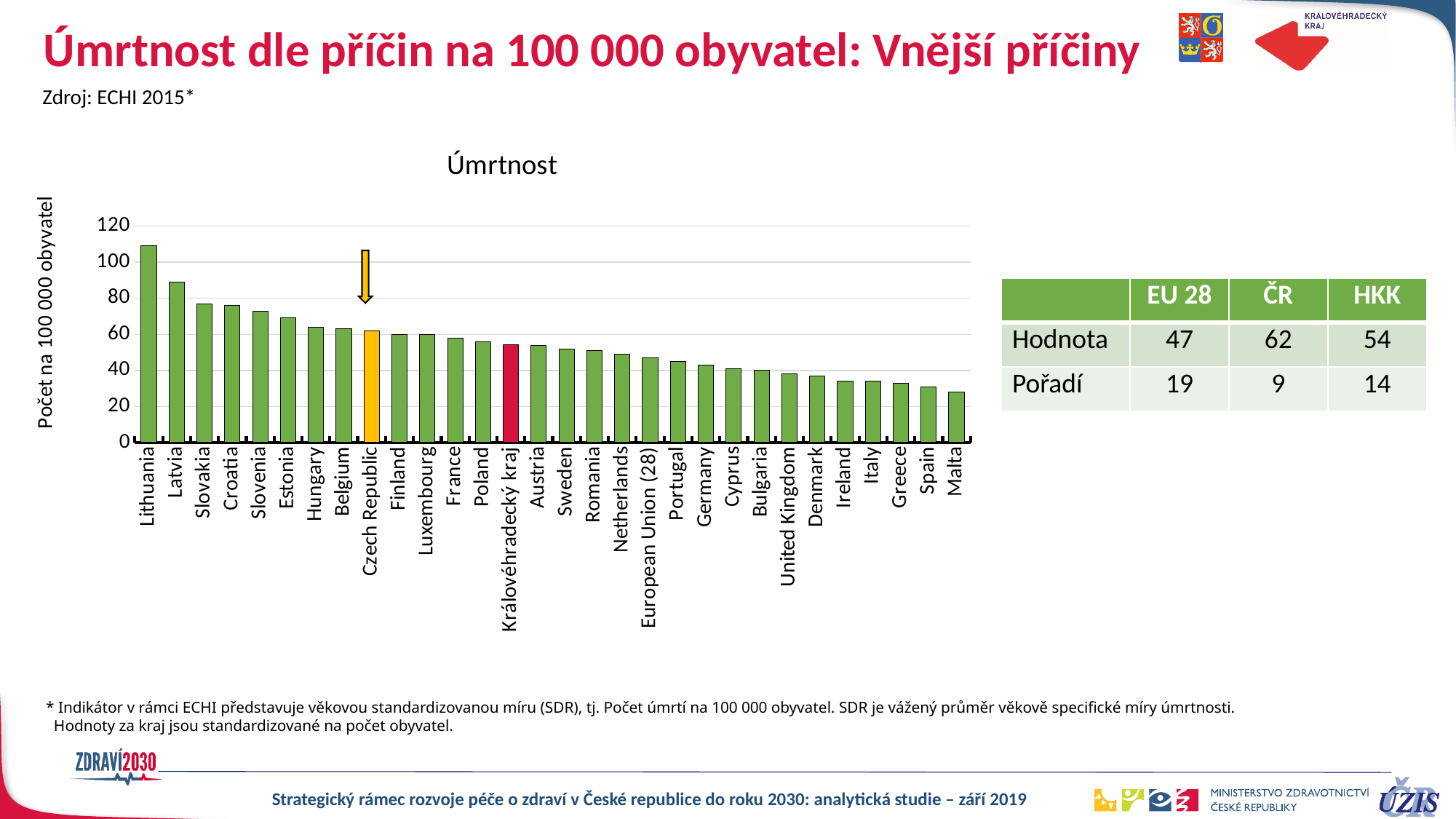
What is the title of the chart? Úmrtnost Is the value for Czech Republic greater or less than 40? greater Which country has the lowest mortality value in the chart? Malta Is the value for Královéhradecký kraj greater or less than 60? less Which has a larger value, Latvia or Croatia? Latvia What kind of chart is shown on the slide? bar chart Do the values rise or fall moving from left to right along the x axis? fall What is the label of the vertical axis of the chart? Počet na 100 000 obyvatel Is the value for Lithuania greater or less than 100? greater Which country has the highest mortality value in the chart? Lithuania How many categories (bars) are plotted in the chart? 30